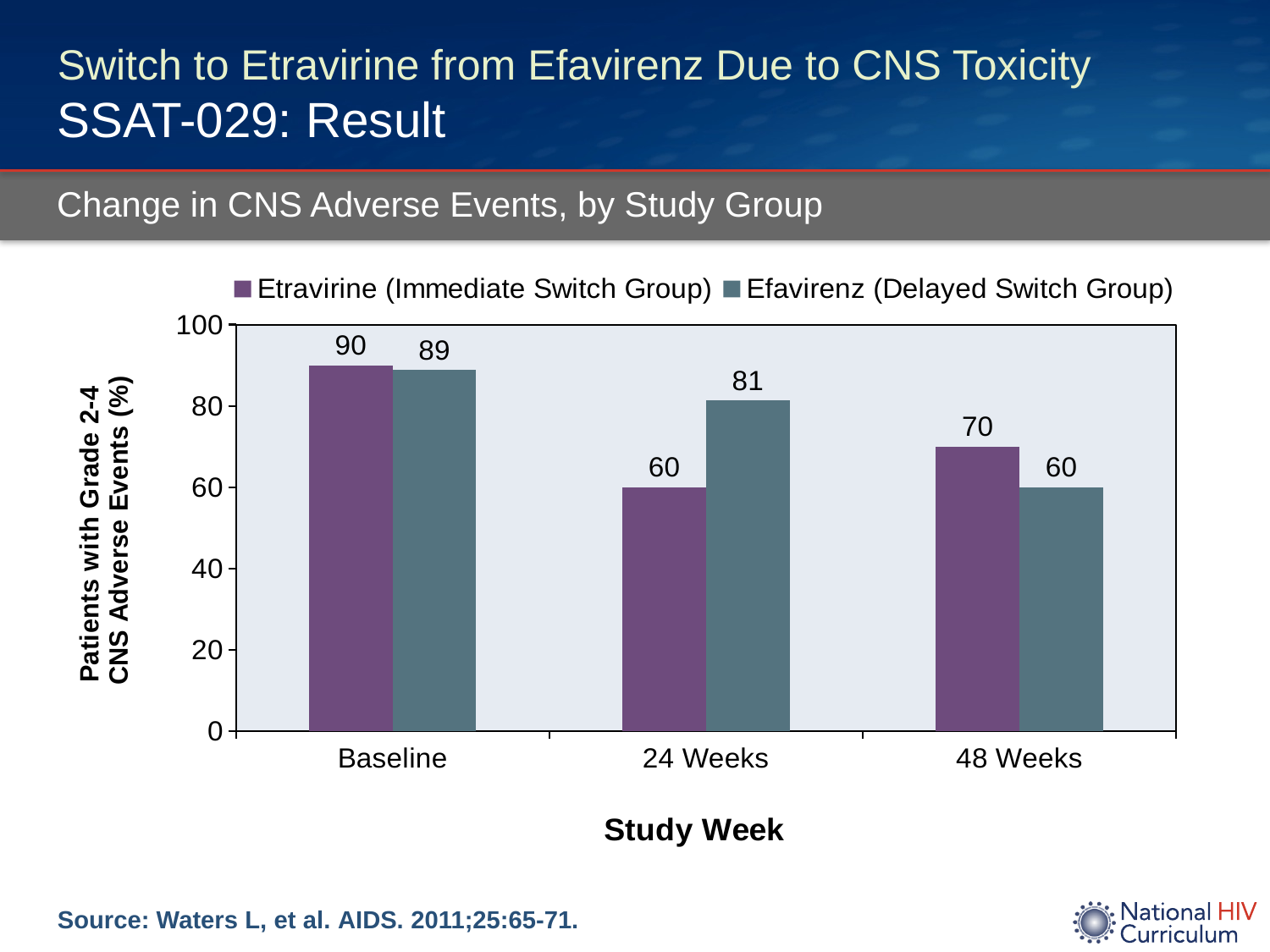
What is the value for Etravirine (Immediate Switch Group) at Baseline? 90 At 48 Weeks, which group has the larger value, Etravirine (Immediate Switch Group) or Efavirenz (Delayed Switch Group)? Etravirine (Immediate Switch Group) What is the value for Efavirenz (Delayed Switch Group) at 24 Weeks? 81 What is the value for Etravirine (Immediate Switch Group) at 48 Weeks? 70 At which study week is the Etravirine (Immediate Switch Group) value lowest? 24 Weeks What is the value for Efavirenz (Delayed Switch Group) at 48 Weeks? 60 At which study week is the Efavirenz (Delayed Switch Group) value highest? Baseline What kind of chart is shown on the slide? Bar chart What is the difference between the Efavirenz (Delayed Switch Group) and Etravirine (Immediate Switch Group) values at 24 Weeks? 21 How many series does the legend list? 2 How many study week categories are shown on the x axis? 3 Is the value for Efavirenz (Delayed Switch Group) at 24 Weeks greater or less than 80? greater